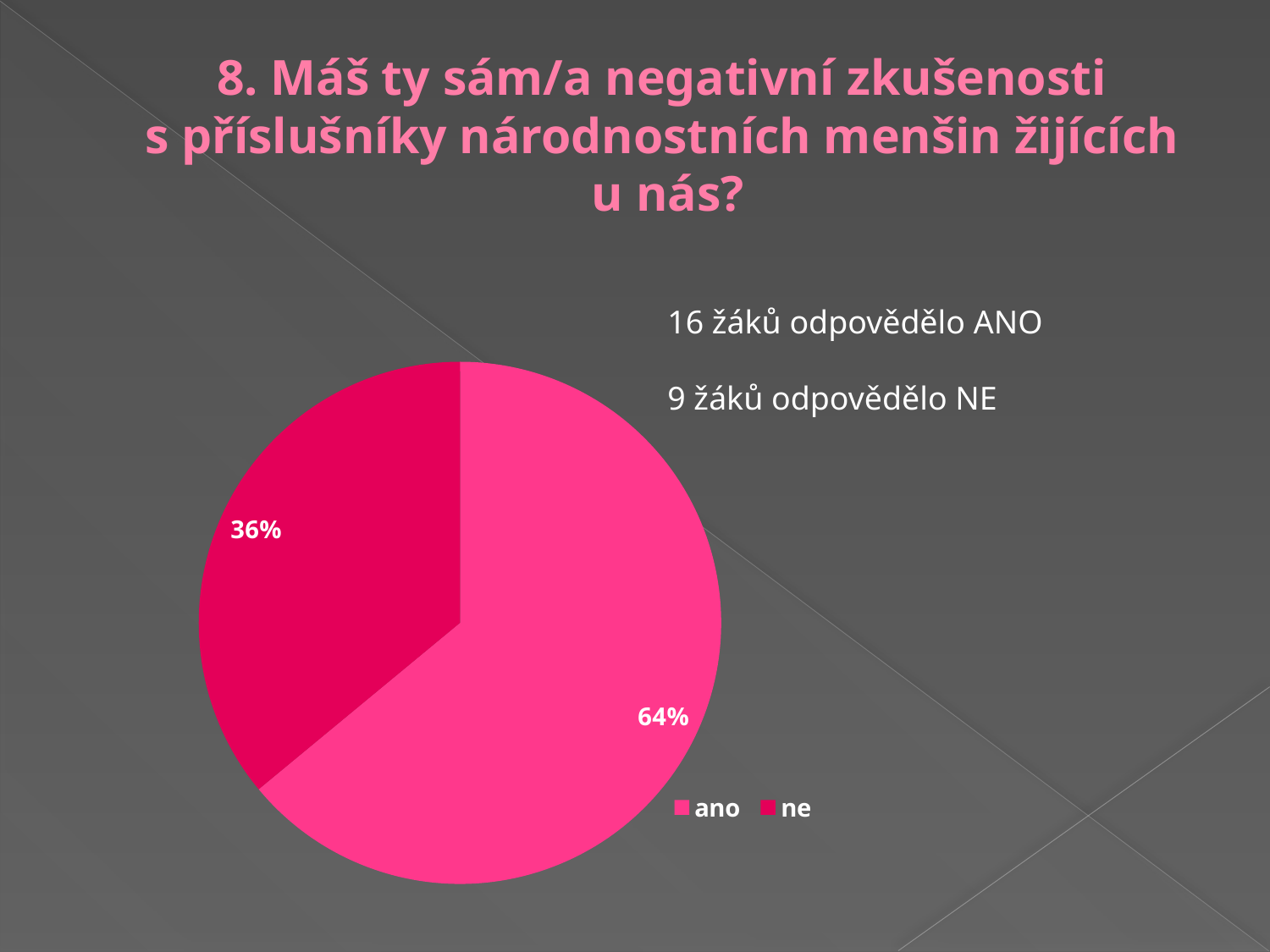
What share of the pie does the "ne" slice take? 36% What is the difference in percentage points between the "ano" and "ne" slices? 28 How many slices does the pie chart have? 2 Which slice is larger, "ano" or "ne"? ano What kind of chart is shown on the slide? pie chart How many entries does the legend list? 2 What percentage of the pie is labelled for the "ano" slice? 64% What are the two legend entries of the pie chart? ano, ne According to the text next to the chart, how many pupils answered ANO? 16 What percentage of the pie is labelled for the "ne" slice? 36% Which slice of the pie is the largest? ano Which slice of the pie is the smallest? ne